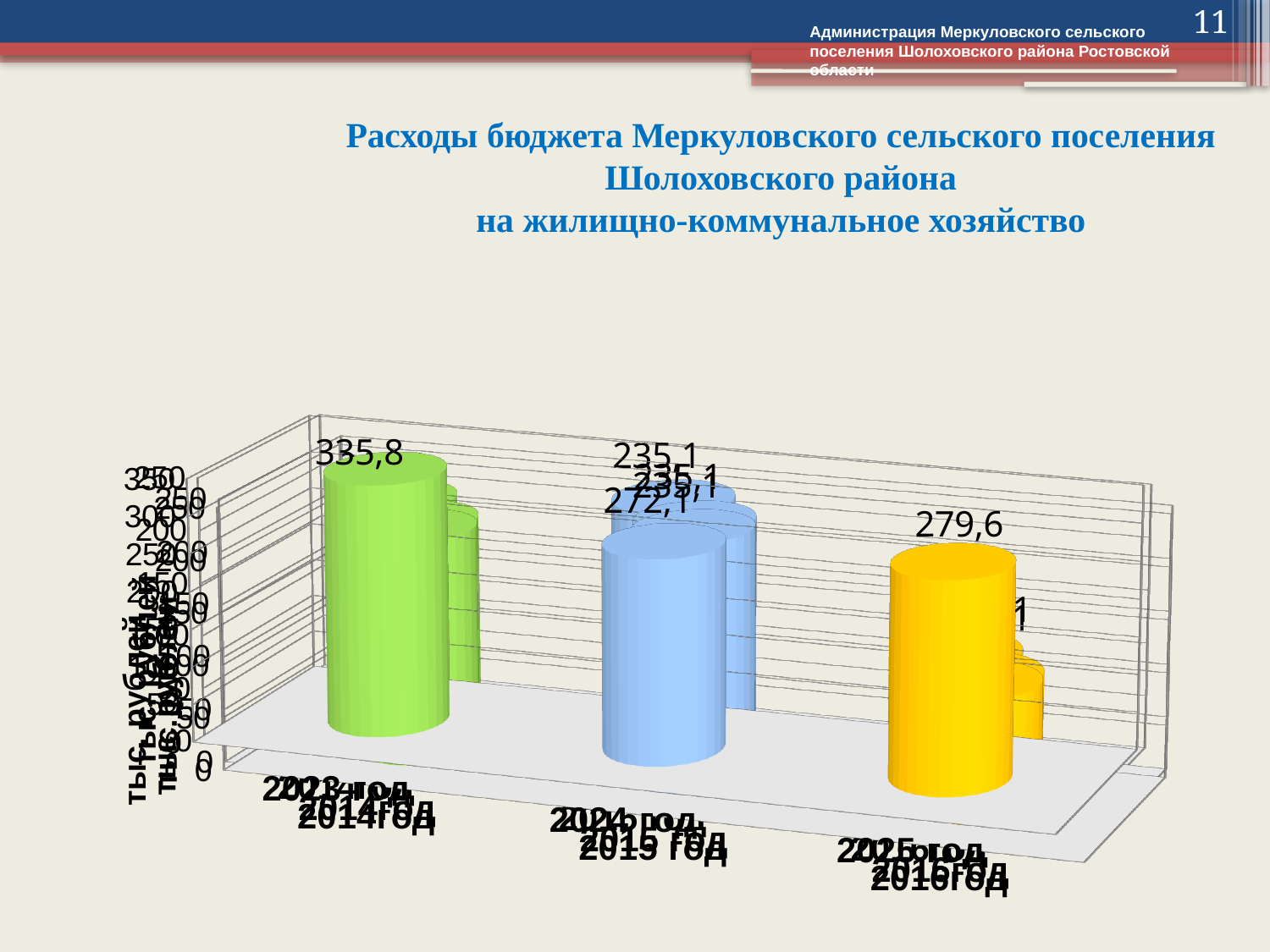
In the front chart, what value is labelled on the blue cylinder? 272,1 In the front chart, which cylinder has the highest value? the green cylinder (335,8) In the front chart, do the values fall or rise from the green cylinder to the blue cylinder? fall What kind of chart is shown on the slide? bar chart In the front chart, what is the difference between the green cylinder's value and the blue cylinder's value? 63,7 In the front chart, what value is labelled on the yellow cylinder? 279,6 In the front chart, what is the difference between the yellow cylinder's value and the blue cylinder's value? 7,5 What is the title of the chart on the slide? Расходы бюджета Меркуловского сельского поселения Шолоховского района на жилищно-коммунальное хозяйство In the front chart, what value is labelled on the green cylinder? 335,8 In the front chart, which is larger: the yellow cylinder's value or the blue cylinder's value? the yellow cylinder (279,6) In the front chart, which cylinder has the lowest value? the blue cylinder (272,1) How many cylinders (bars) are plotted in the front chart? 3